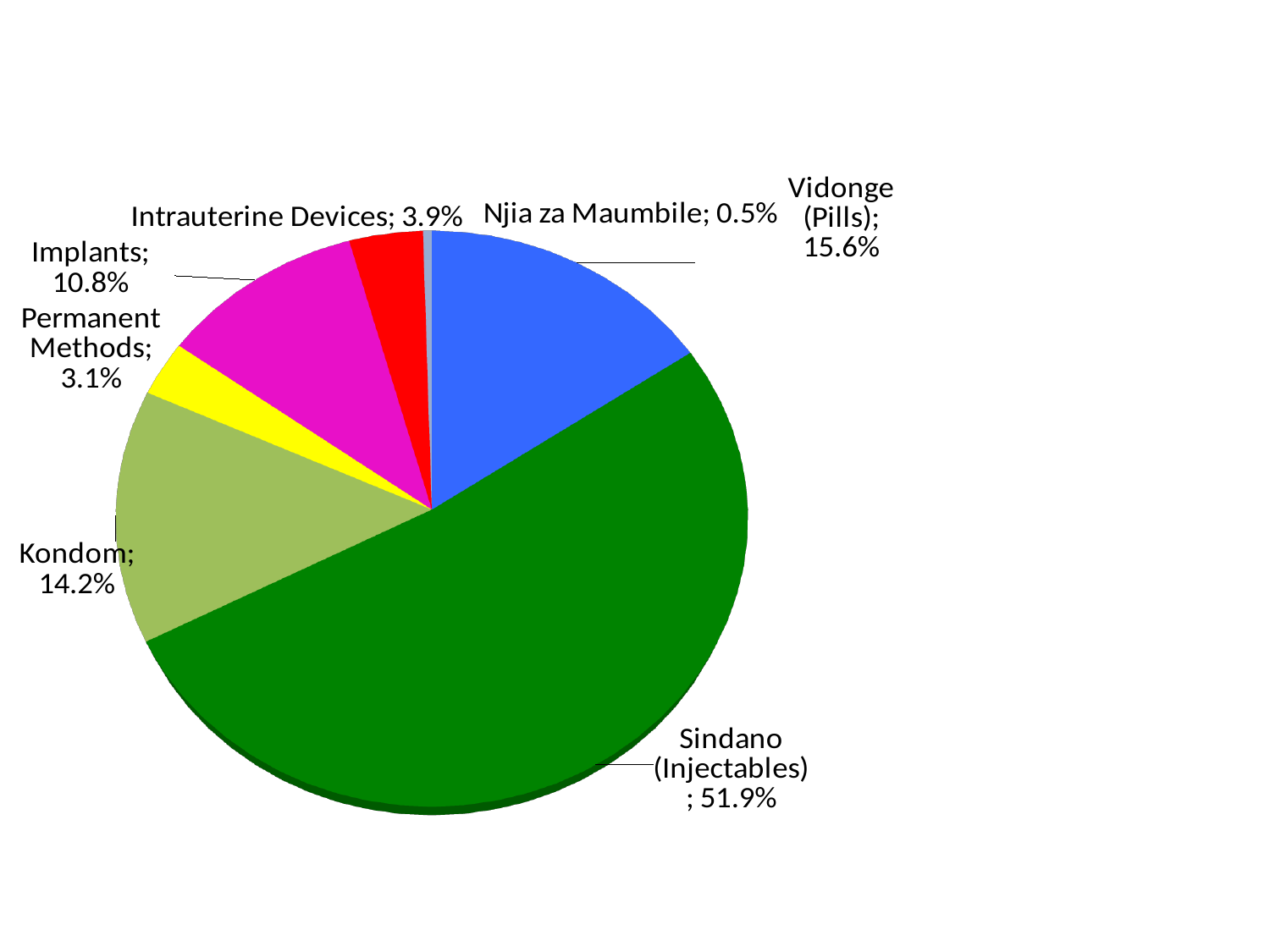
What share of the pie does Sindano (Injectables) have? 51.9% What is the value for Implants? 10.8% Which is larger, Implants or Permanent Methods? Implants Which category has the largest slice of the pie? Sindano (Injectables) Which category has the smallest slice of the pie? Njia za Maumbile What kind of chart is shown on the slide? pie chart What is the difference between the values for Vidonge (Pills) and Kondom? 1.4% How many slices does the pie chart have? 7 What is the value for Kondom? 14.2% What is the value for Vidonge (Pills)? 15.6% What is the value for Intrauterine Devices? 3.9% What colour is the Sindano (Injectables) slice? green